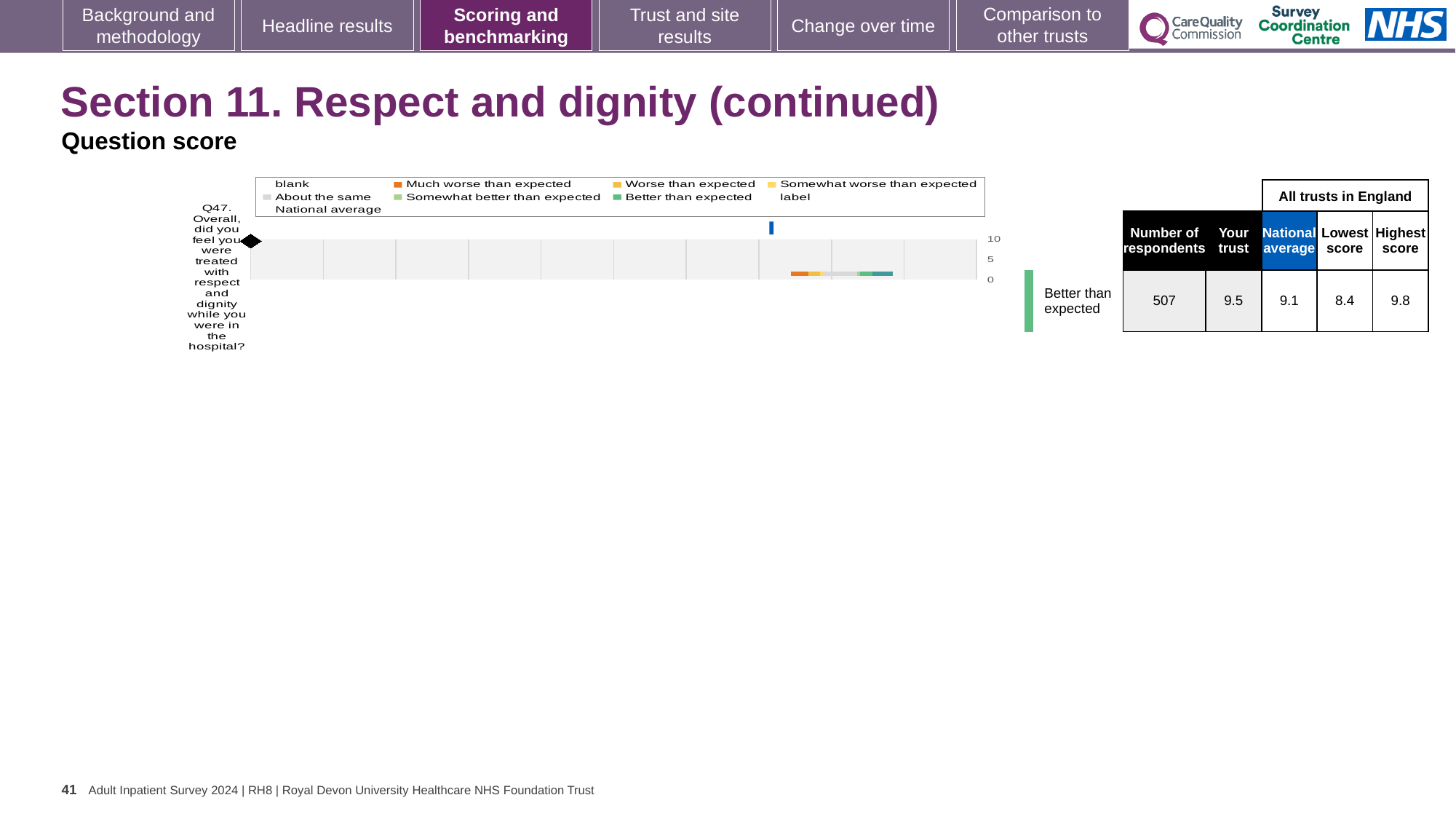
What kind of chart is shown for Q47 on the slide? bar chart What is the lowest score among all trusts in England for Q47? 8.4 What is the difference between the highest score and the lowest score for Q47? 1.4 What is the difference between the 'Your trust' score and the national average for Q47? 0.4 Which question number is plotted in the chart on this slide? Q47 How many survey questions are plotted in the chart on this slide? 1 For Q47, which is larger: the 'Your trust' score or the national average? Your trust What benchmark category label is shown for the trust's Q47 result? Better than expected How many respondents answered Q47 according to the table? 507 What is the national average score for Q47 shown in the table? 9.1 What is the 'Your trust' score for Q47 shown in the table next to the chart? 9.5 What is the highest score among all trusts in England for Q47? 9.8